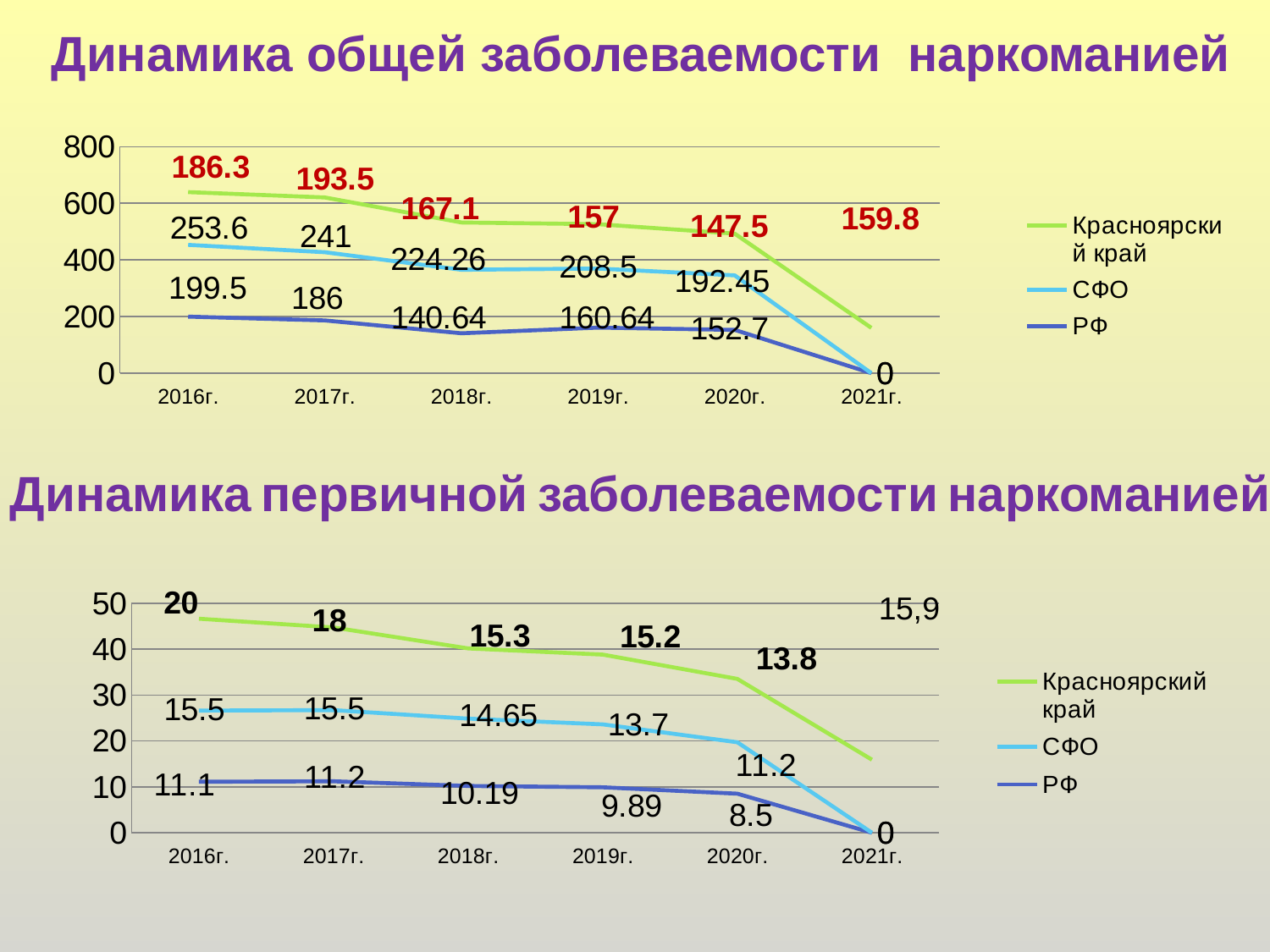
On the chart 'Динамика первичной заболеваемости наркоманией', in which year is the labelled value for Красноярский край the highest? 2016г. On the chart 'Динамика первичной заболеваемости наркоманией', what is the labelled value for РФ in 2018г.? 10.19 On the chart 'Динамика общей заболеваемости наркоманией', in which year is the labelled value for Красноярский край the lowest? 2020г. On the chart 'Динамика общей заболеваемости наркоманией', what is the labelled value for СФО in 2018г.? 224.26 On the chart 'Динамика общей заболеваемости наркоманией', how many series does the legend list? 3 On the chart 'Динамика общей заболеваемости наркоманией', what is the labelled value for Красноярский край in 2017г.? 193.5 On the chart 'Динамика первичной заболеваемости наркоманией', does the СФО line rise or fall from 2016г. to 2021г.? Fall On the chart 'Динамика общей заболеваемости наркоманией', what is the difference between the labelled values for СФО and РФ in 2016г.? 54.1 On the chart 'Динамика первичной заболеваемости наркоманией', how many years are shown on the x axis? 6 On the chart 'Динамика первичной заболеваемости наркоманией', what is the labelled value for Красноярский край in 2020г.? 13.8 What kind of chart is 'Динамика первичной заболеваемости наркоманией'? Line chart On the chart 'Динамика общей заболеваемости наркоманией', what is the labelled value for РФ in 2019г.? 160.64